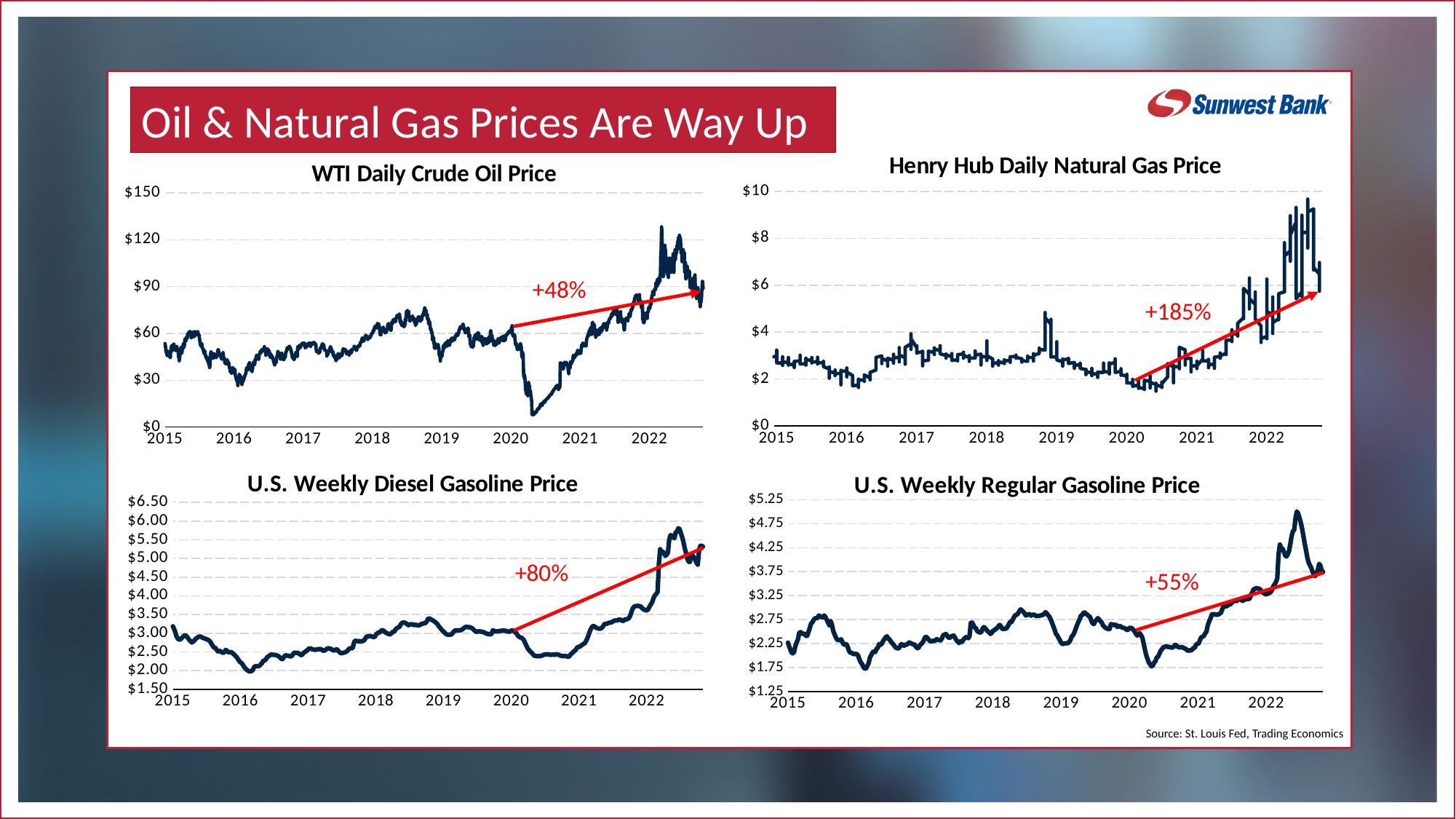
How many charts are shown on the slide? 4 On the U.S. Weekly Regular Gasoline Price chart, what percentage change is annotated on the red arrow? +55% On the Henry Hub Daily Natural Gas Price chart, is the peak value in 2022 greater or less than $8? greater Which of the four charts shows the smallest annotated percentage increase? WTI Daily Crude Oil Price What kind of chart is the WTI Daily Crude Oil Price chart? Line chart On the U.S. Weekly Diesel Gasoline Price chart, does the price rise or fall between 2020 and 2022? Rise On the WTI Daily Crude Oil Price chart, is the lowest value in 2020 greater or less than $30? less On the WTI Daily Crude Oil Price chart, what percentage change is annotated on the red arrow? +48% Which of the four charts shows the largest annotated percentage increase? Henry Hub Daily Natural Gas Price On the U.S. Weekly Diesel Gasoline Price chart, what percentage change is annotated on the red arrow? +80% On the U.S. Weekly Regular Gasoline Price chart, is the lowest value in 2016 greater or less than $2.25? less On the Henry Hub Daily Natural Gas Price chart, what percentage change is annotated on the red arrow? +185%